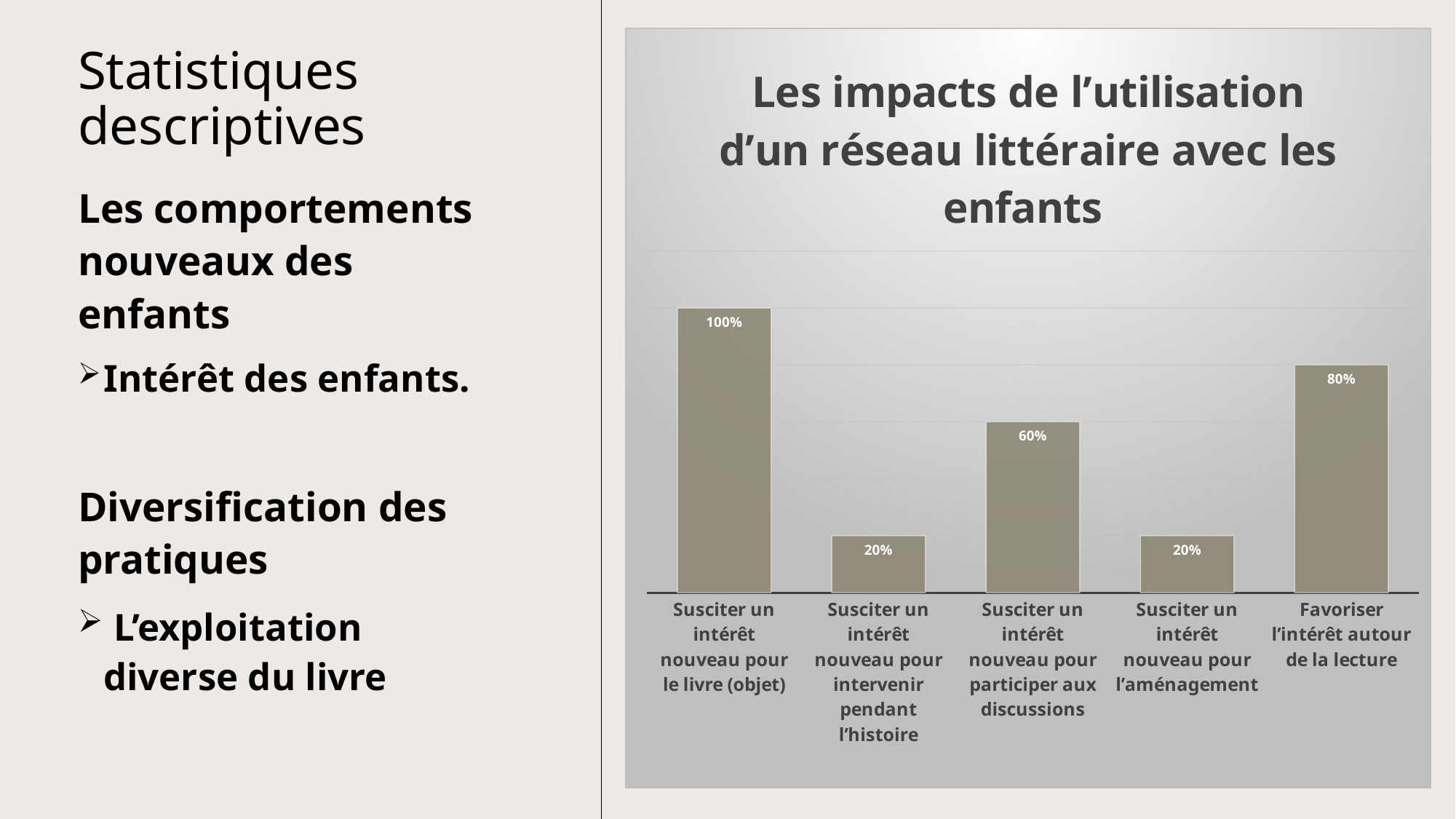
What is the title of the chart? Les impacts de l'utilisation d'un réseau littéraire avec les enfants What is the value for 'Favoriser l'intérêt autour de la lecture'? 80% How many categories are shown in the chart? 5 Which category has the highest value? Susciter un intérêt nouveau pour le livre (objet) What is the difference between the values for 'Susciter un intérêt nouveau pour le livre (objet)' and 'Favoriser l'intérêt autour de la lecture'? 20% Which is larger: the value for 'Favoriser l'intérêt autour de la lecture' or the value for 'Susciter un intérêt nouveau pour participer aux discussions'? Favoriser l'intérêt autour de la lecture What kind of chart is shown on the slide? Bar chart How many categories have a value of 20%? 2 What is the value for 'Susciter un intérêt nouveau pour le livre (objet)'? 100% What is the value for 'Susciter un intérêt nouveau pour intervenir pendant l'histoire'? 20% What is the value for 'Susciter un intérêt nouveau pour participer aux discussions'? 60% What is the difference between the values for 'Susciter un intérêt nouveau pour participer aux discussions' and 'Susciter un intérêt nouveau pour l'aménagement'? 40%